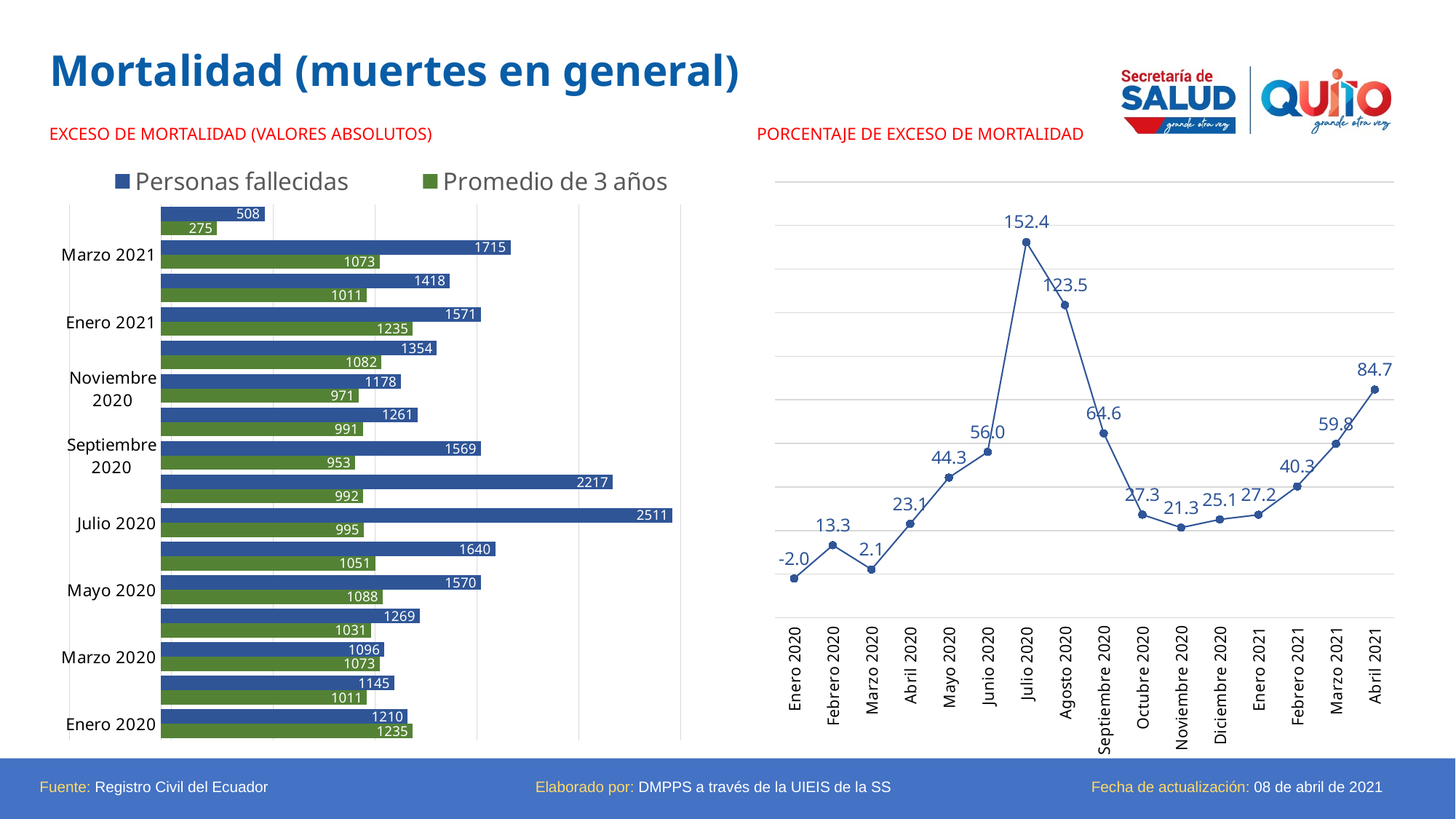
In the chart titled 'PORCENTAJE DE EXCESO DE MORTALIDAD', what is the difference between the values for Julio 2020 and Agosto 2020? 28.9 In the chart titled 'EXCESO DE MORTALIDAD (VALORES ABSOLUTOS)', for Enero 2020, which is larger: 'Personas fallecidas' or 'Promedio de 3 años'? Promedio de 3 años How many data points are plotted in the chart titled 'PORCENTAJE DE EXCESO DE MORTALIDAD'? 16 In the chart titled 'EXCESO DE MORTALIDAD (VALORES ABSOLUTOS)', what is the value of 'Personas fallecidas' for Julio 2020? 2511 What kind of chart is the chart titled 'EXCESO DE MORTALIDAD (VALORES ABSOLUTOS)'? Bar chart In the chart titled 'PORCENTAJE DE EXCESO DE MORTALIDAD', which month has the lowest value? Enero 2020 In the chart titled 'EXCESO DE MORTALIDAD (VALORES ABSOLUTOS)', which labelled month has the highest value for 'Personas fallecidas'? Julio 2020 How many series does the legend of the chart titled 'EXCESO DE MORTALIDAD (VALORES ABSOLUTOS)' list? 2 In the chart titled 'EXCESO DE MORTALIDAD (VALORES ABSOLUTOS)', what is the value of 'Promedio de 3 años' for Enero 2021? 1235 In the chart titled 'PORCENTAJE DE EXCESO DE MORTALIDAD', do the values rise or fall from Enero 2021 to Abril 2021? Rise In the chart titled 'PORCENTAJE DE EXCESO DE MORTALIDAD', what is the value for Julio 2020? 152.4 In the chart titled 'EXCESO DE MORTALIDAD (VALORES ABSOLUTOS)', what is the difference between 'Personas fallecidas' and 'Promedio de 3 años' for Marzo 2021? 642